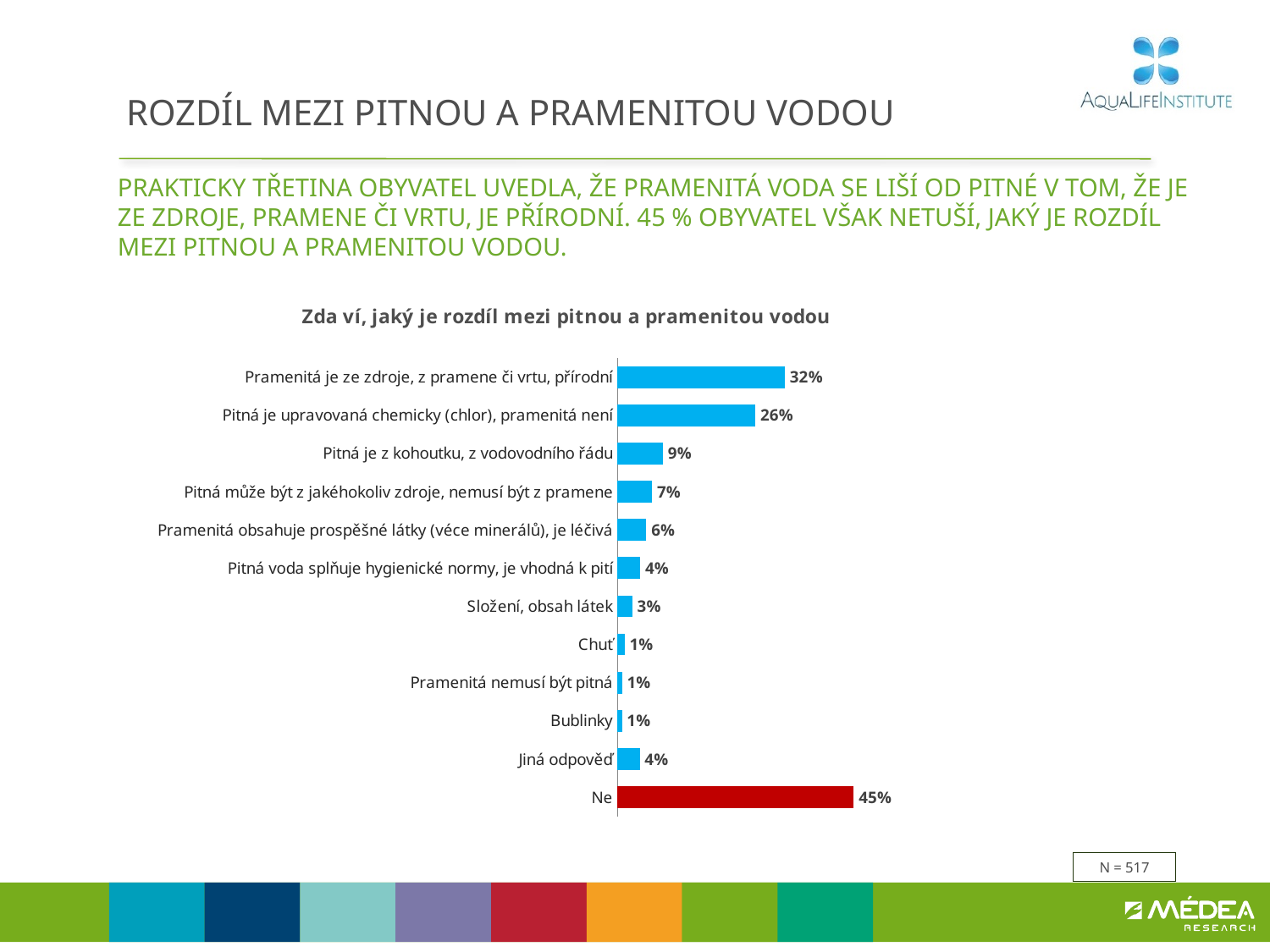
What is the value for "Pitná je z kohoutku, z vodovodního řádu"? 9% What is the value for "Ne"? 45% What is the difference between "Pramenitá je ze zdroje, z pramene či vrtu, přírodní" and "Pitná je upravovaná chemicky (chlor), pramenitá není"? 6% Which category has the highest value? Ne What is the title of the chart? Zda ví, jaký je rozdíl mezi pitnou a pramenitou vodou What is the difference between "Ne" and "Pramenitá je ze zdroje, z pramene či vrtu, přírodní"? 13% What is the value for "Složení, obsah látek"? 3% What kind of chart is shown on the slide? Bar chart What is the value for "Pramenitá je ze zdroje, z pramene či vrtu, přírodní"? 32% How many categories are shown in the chart? 12 Which bar is coloured differently (red) from the others? Ne Which is larger: "Pitná může být z jakéhokoliv zdroje, nemusí být z pramene" or "Pitná voda splňuje hygienické normy, je vhodná k pití"? Pitná může být z jakéhokoliv zdroje, nemusí být z pramene